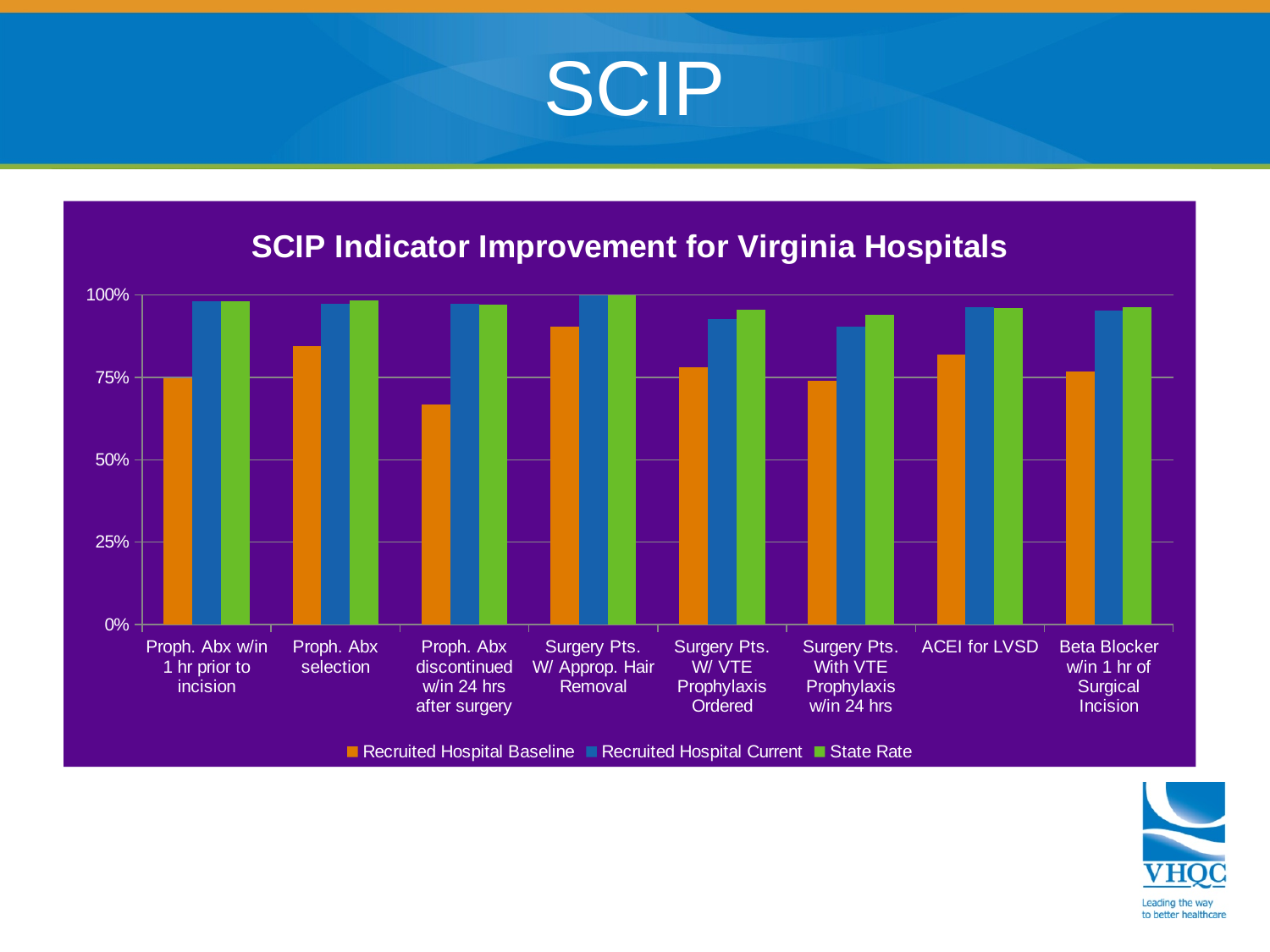
How many series does the legend list? 3 What is the title of the chart? SCIP Indicator Improvement for Virginia Hospitals Is the Recruited Hospital Baseline value for Proph. Abx discontinued w/in 24 hrs after surgery greater or less than 75%? less Is the Recruited Hospital Current value for Surgery Pts. With VTE Prophylaxis w/in 24 hrs greater or less than 75%? greater Which category has the highest Recruited Hospital Baseline value? Surgery Pts. W/ Approp. Hair Removal Which has the larger Recruited Hospital Baseline value: Proph. Abx selection or Proph. Abx discontinued w/in 24 hrs after surgery? Proph. Abx selection How many indicator categories are shown on the x axis? 8 Which category has the lowest Recruited Hospital Baseline value? Proph. Abx discontinued w/in 24 hrs after surgery For ACEI for LVSD, which is larger: the Recruited Hospital Baseline or the Recruited Hospital Current value? Recruited Hospital Current Which series is shown in orange? Recruited Hospital Baseline Is the Recruited Hospital Baseline value for Proph. Abx selection greater or less than 75%? greater What type of chart is shown on the slide? Bar chart